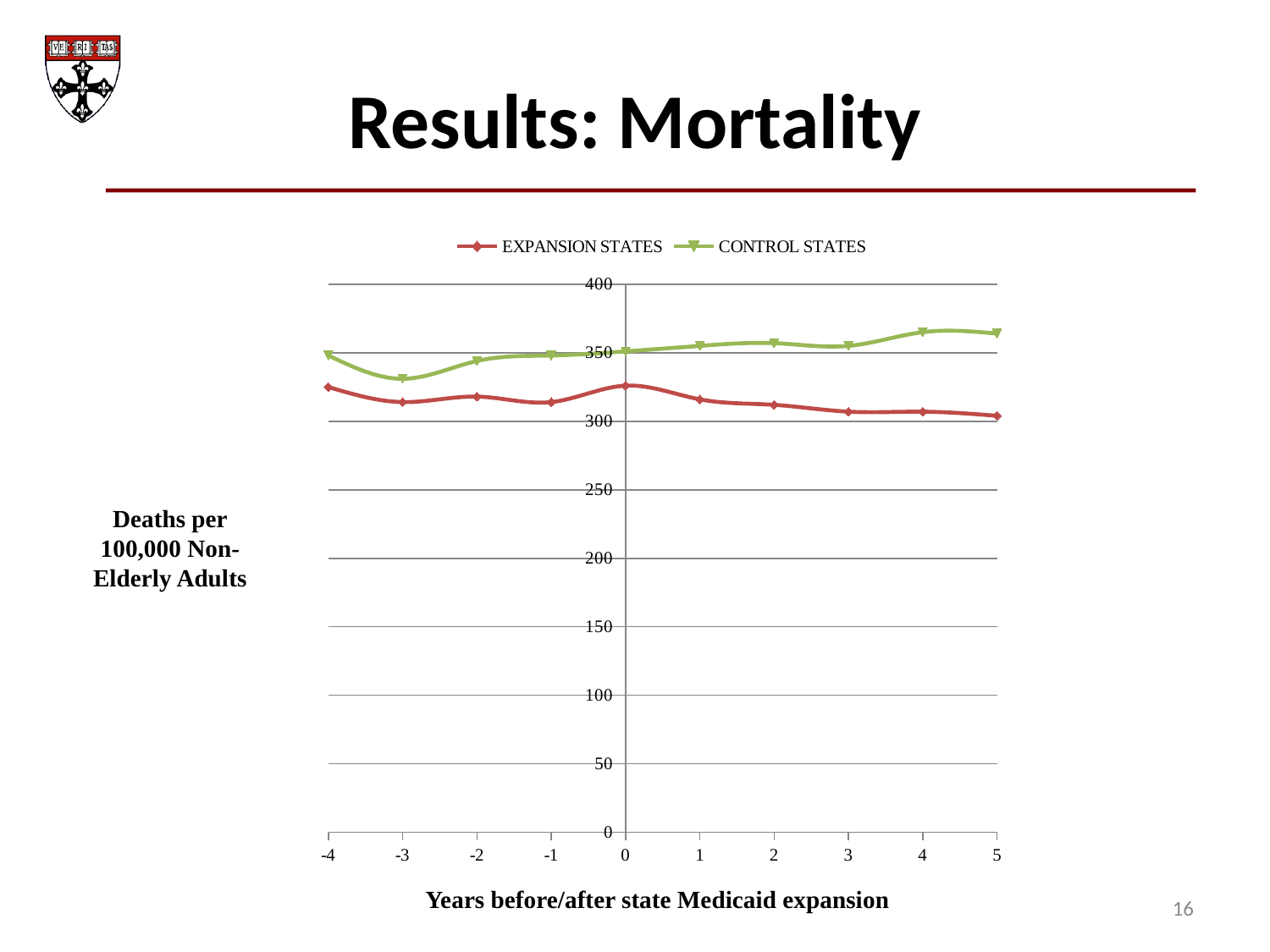
Is the value for EXPANSION STATES at year -4 greater or less than 300? greater Do the values for CONTROL STATES generally rise or fall from year -3 to year 5? rise How many points along the x axis (years) are plotted for each series? 10 Is the value for CONTROL STATES at year 5 greater or less than 350? greater Do the values for EXPANSION STATES generally rise or fall from year 0 to year 5? fall Is the value for CONTROL STATES at year -3 greater or less than 350? less What is the x-axis title of the chart? Years before/after state Medicaid expansion How many series does the legend list? 2 What kind of chart is shown on the slide? line chart At which year does CONTROL STATES reach its lowest value? -3 At year 0, which series has the higher value, EXPANSION STATES or CONTROL STATES? CONTROL STATES